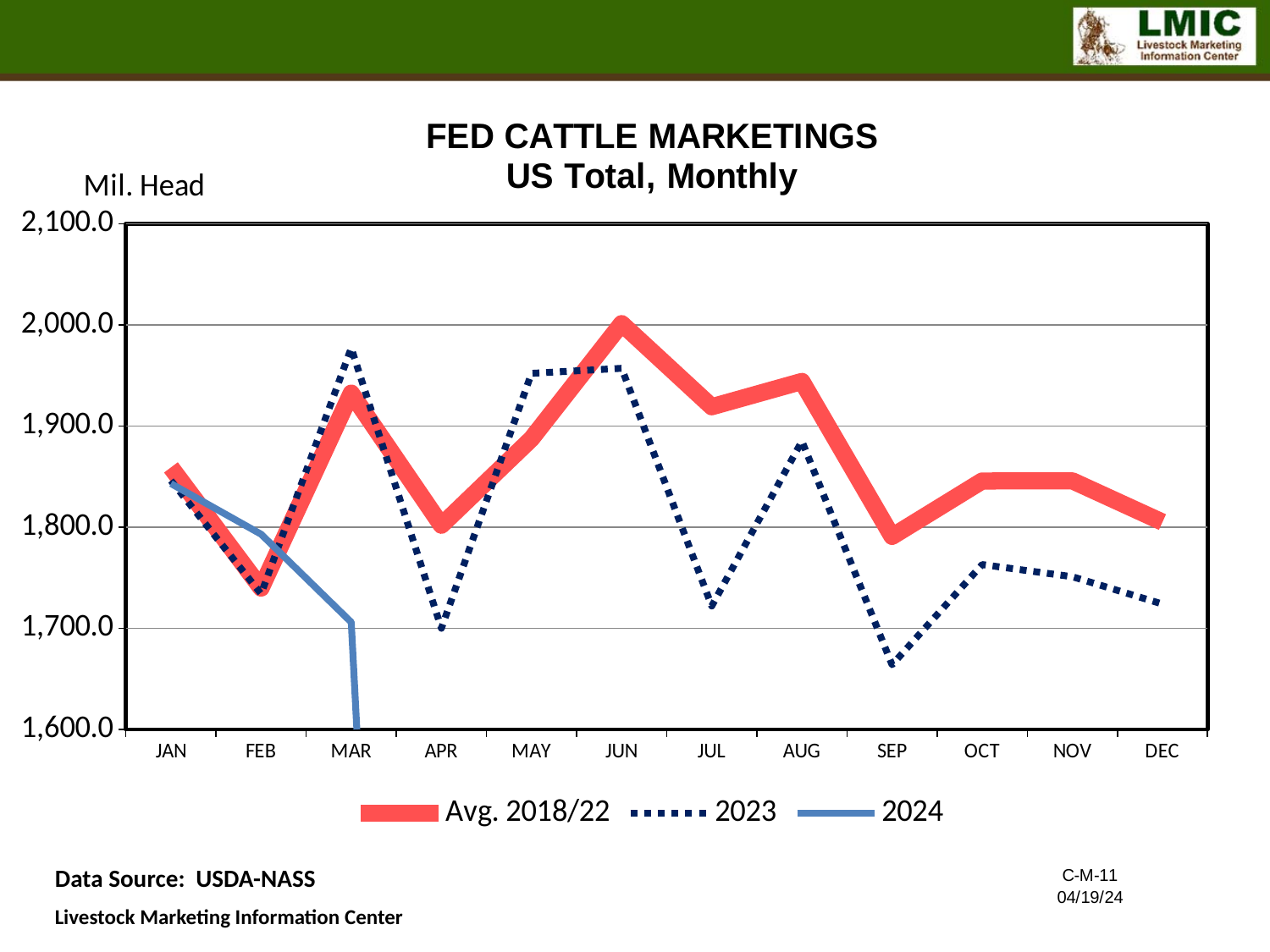
In which month does the 2023 series reach its highest value? MAR Does the 2023 series rise or fall from OCT to DEC? fall Is the 2023 value for MAR greater or less than 1,900.0? greater Is the 2023 value for SEP greater or less than 1,700.0? less In which month does the 2023 series reach its lowest value? SEP Is the Avg. 2018/22 value for FEB greater or less than 1,800.0? less In which month does the Avg. 2018/22 series reach its lowest value? FEB What type of chart is shown on the slide? line chart In JUL, which series has the larger value, Avg. 2018/22 or 2023? Avg. 2018/22 In which month does the Avg. 2018/22 series reach its highest value? JUN How many months are shown along the x axis? 12 How many series does the legend list? 3